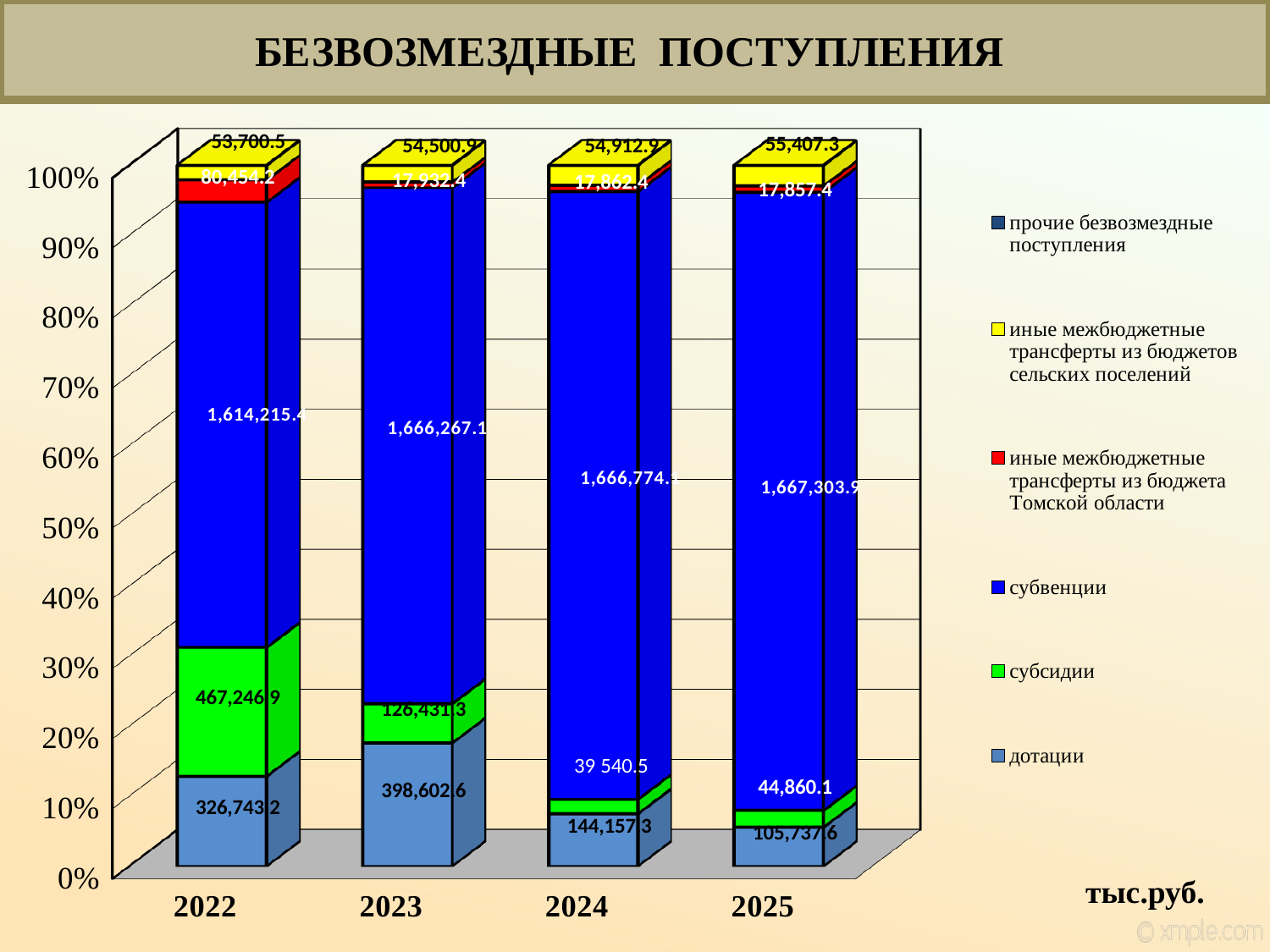
What is the difference between иные межбюджетные трансферты из бюджетов сельских поселений in 2023 and in 2022? 800.4 What is the value of иные межбюджетные трансферты из бюджетов сельских поселений for 2025? 55,407.3 In which year is the value of дотации the lowest? 2025 What is the value of дотации for 2023? 398,602.6 In which year is the value of субсидии the highest? 2022 In what units are the values on the chart given? тыс.руб. How many years are shown on the x axis? 4 Which is larger, дотации in 2022 or дотации in 2023? 2023 What is the value of иные межбюджетные трансферты из бюджета Томской области for 2022? 80,454.2 How many series does the legend list? 6 What is the value of субвенции for 2022? 1,614,215.4 What kind of chart is shown on the slide? stacked bar chart